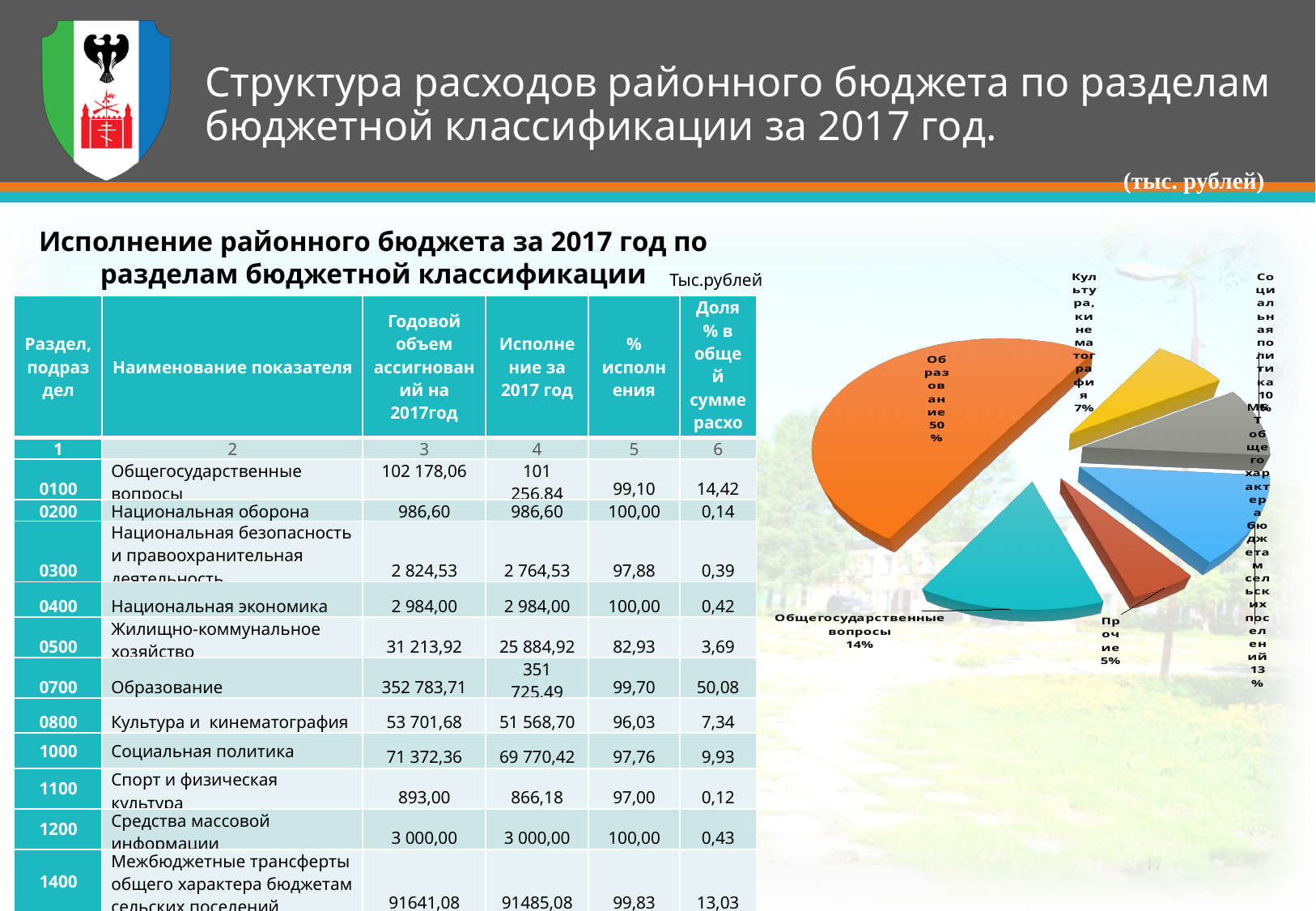
How many slices does the pie chart have? 6 Which slice of the pie chart is the smallest? Прочие In the pie chart, what share does Общегосударственные вопросы have? 14% In the pie chart, how many percentage points larger is Образование than Общегосударственные вопросы? 36% What colour is the largest slice (Образование) in the pie chart? orange In the pie chart, what share does Образование have? 50% In the pie chart, what share does Прочие have? 5% Which slice of the pie chart is the largest? Образование What kind of chart is shown on the right side of the slide? pie chart In the pie chart, which is larger: Общегосударственные вопросы or Социальная политика? Общегосударственные вопросы